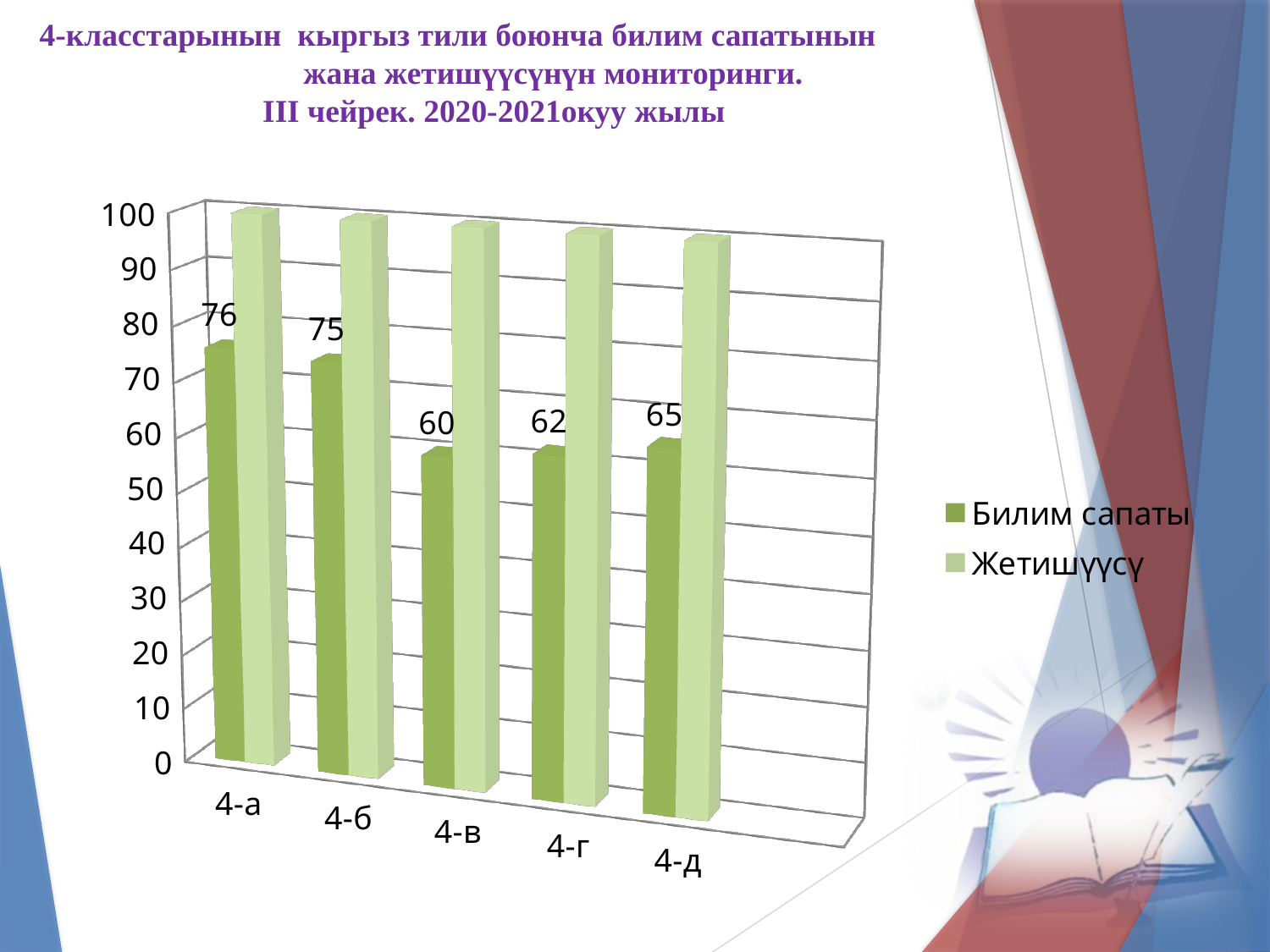
Which is larger, the Билим сапаты value for 4-г or for 4-д? 4-д What is the value of Билим сапаты for 4-д? 65 What is the value of Билим сапаты for 4-в? 60 How many series does the legend list? 2 Which class has the highest Билим сапаты value? 4-а What is the value of Билим сапаты for 4-б? 75 What is the difference between the Билим сапаты values for 4-а and 4-в? 16 How many classes are shown on the x axis? 5 What is the value of Билим сапаты for 4-а? 76 Which class has the lowest Билим сапаты value? 4-в What kind of chart is shown on the slide? bar chart Is the Жетишүүсү value for 4-а greater or less than 90? greater